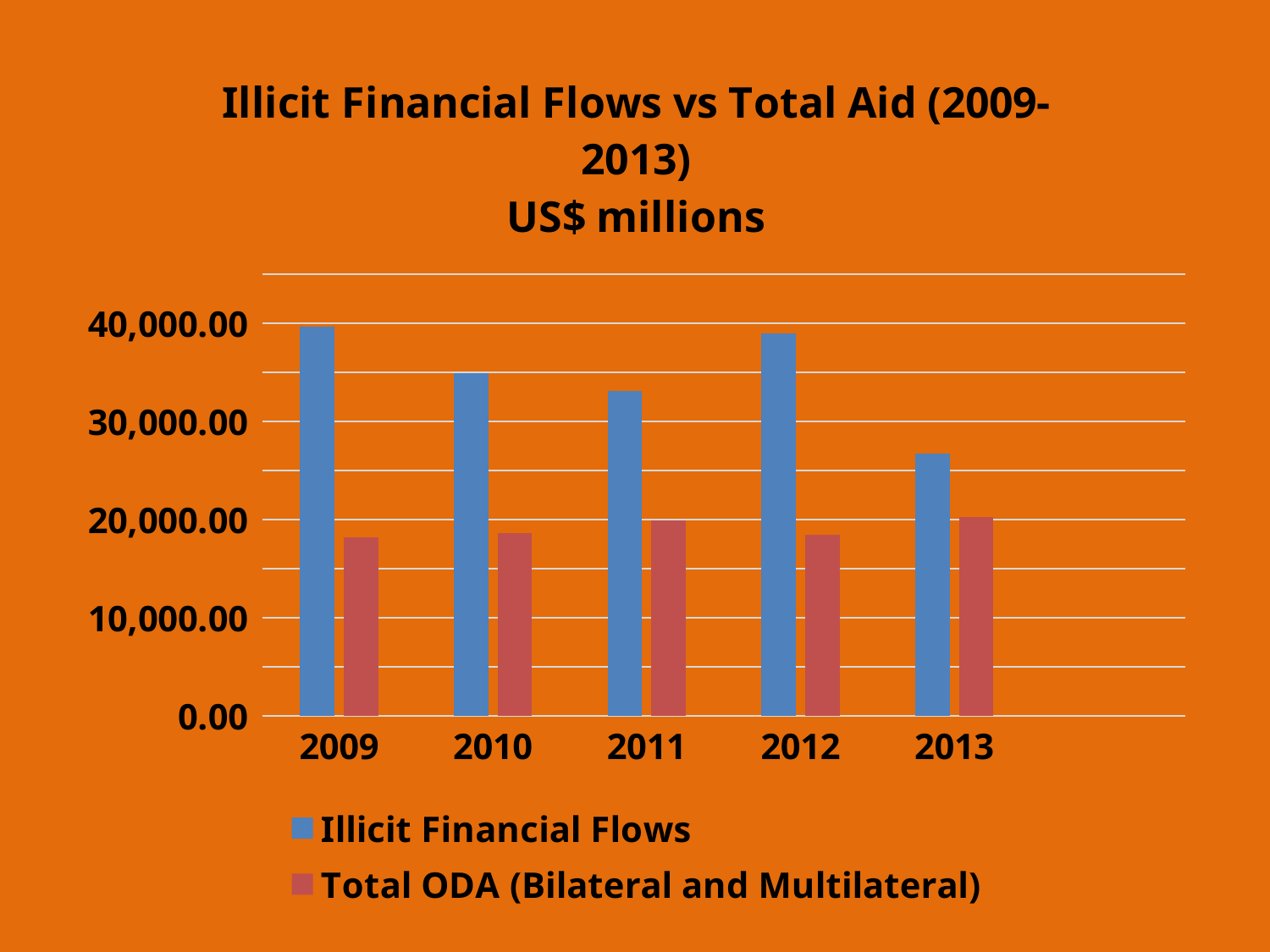
What kind of chart is shown on the slide? Bar chart What is the title of the chart? Illicit Financial Flows vs Total Aid (2009-2013) US$ millions Is the value for Illicit Financial Flows in 2010 greater or less than 30,000.00? greater Is the value for Illicit Financial Flows in 2013 greater or less than 20,000.00? greater How many series does the chart's legend list? 2 Which is larger in 2011: Illicit Financial Flows or Total ODA (Bilateral and Multilateral)? Illicit Financial Flows Is the value for Illicit Financial Flows in 2013 greater or less than 30,000.00? less How many years are shown on the x axis of the chart? 5 Which is larger: Illicit Financial Flows in 2009 or Illicit Financial Flows in 2013? 2009 What colour are the bars for Illicit Financial Flows? Blue Which year has the lowest value for Illicit Financial Flows? 2013